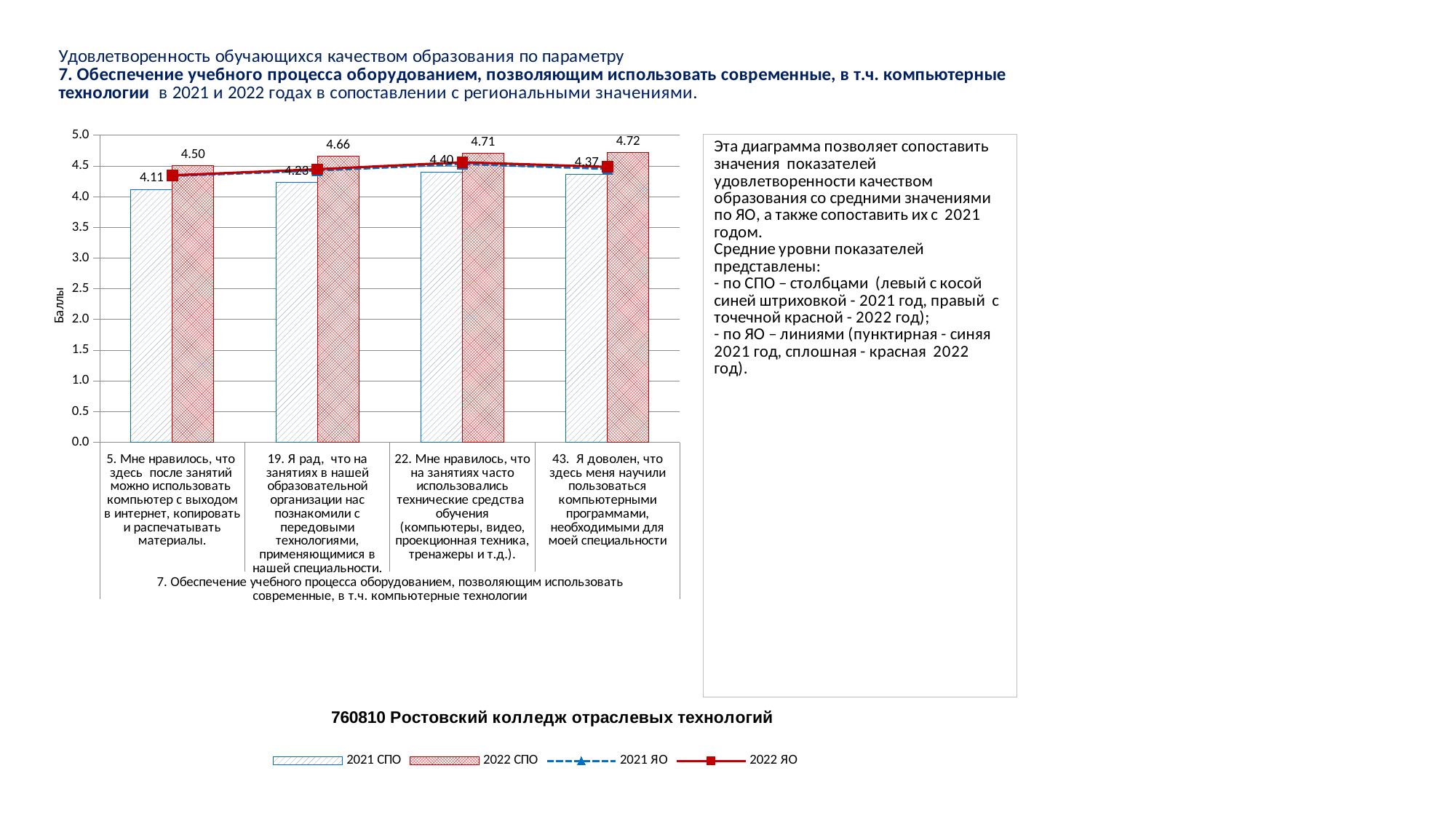
What is the label of the vertical axis? Баллы How many categories are shown on the x axis of the chart? 4 What is the difference between the 2022 СПО and 2021 СПО values for question 5? 0.39 Is the 2021 СПО value for question 43 greater or less than 4.5? less What is the 2022 СПО value for question 5 ("Мне нравилось, что здесь после занятий можно использовать компьютер с выходом в интернет...")? 4.50 Which category has the lowest 2021 СПО value? 5. Мне нравилось, что здесь после занятий можно использовать компьютер с выходом в интернет, копировать и распечатывать материалы. What is the 2022 СПО value for question 43 ("Я доволен, что здесь меня научили пользоваться компьютерными программами...")? 4.72 What is the 2021 СПО value for question 22 ("Мне нравилось, что на занятиях часто использовались технические средства обучения...")? 4.40 What is the 2021 СПО value for question 5? 4.11 Which is larger for question 22: the 2021 СПО value or the 2022 СПО value? 2022 СПО How many series does the chart legend list? 4 Which category has the highest 2022 СПО value? 43. Я доволен, что здесь меня научили пользоваться компьютерными программами, необходимыми для моей специальности